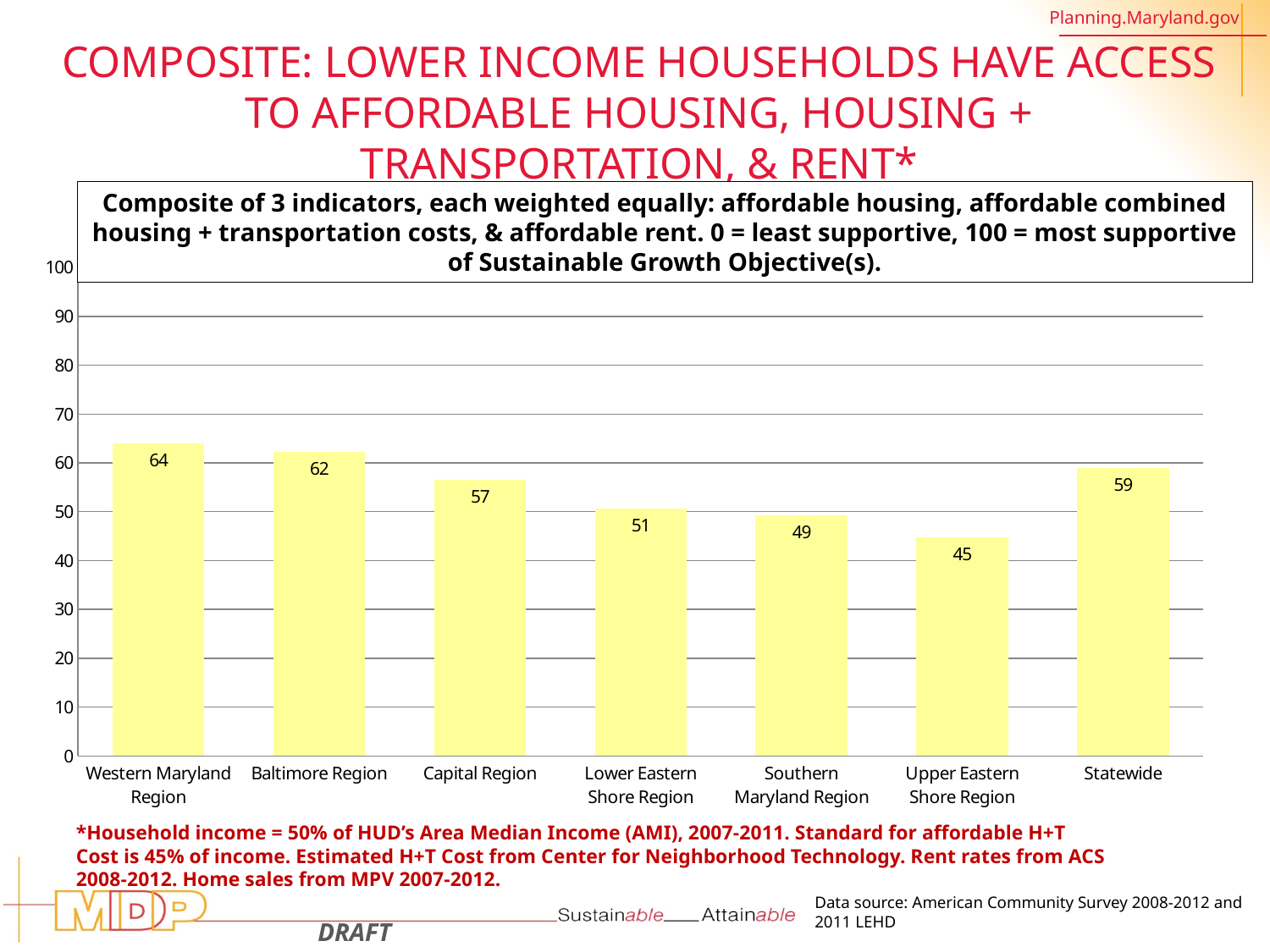
What is the maximum value shown on the y axis? 100 What is the Statewide composite score? 59 Do the values rise or fall from the Western Maryland Region to the Upper Eastern Shore Region? fall Which has a higher composite score, the Capital Region or the Southern Maryland Region? Capital Region What is the difference between the composite scores of the Western Maryland Region and the Upper Eastern Shore Region? 19 How many categories are shown on the x axis? 7 Which region has the lowest composite score? Upper Eastern Shore Region What kind of chart is shown on the slide? bar chart What is the composite score for the Upper Eastern Shore Region? 45 Which region has the highest composite score? Western Maryland Region What is the composite score for the Western Maryland Region? 64 Is the value for the Lower Eastern Shore Region greater or less than 60? less